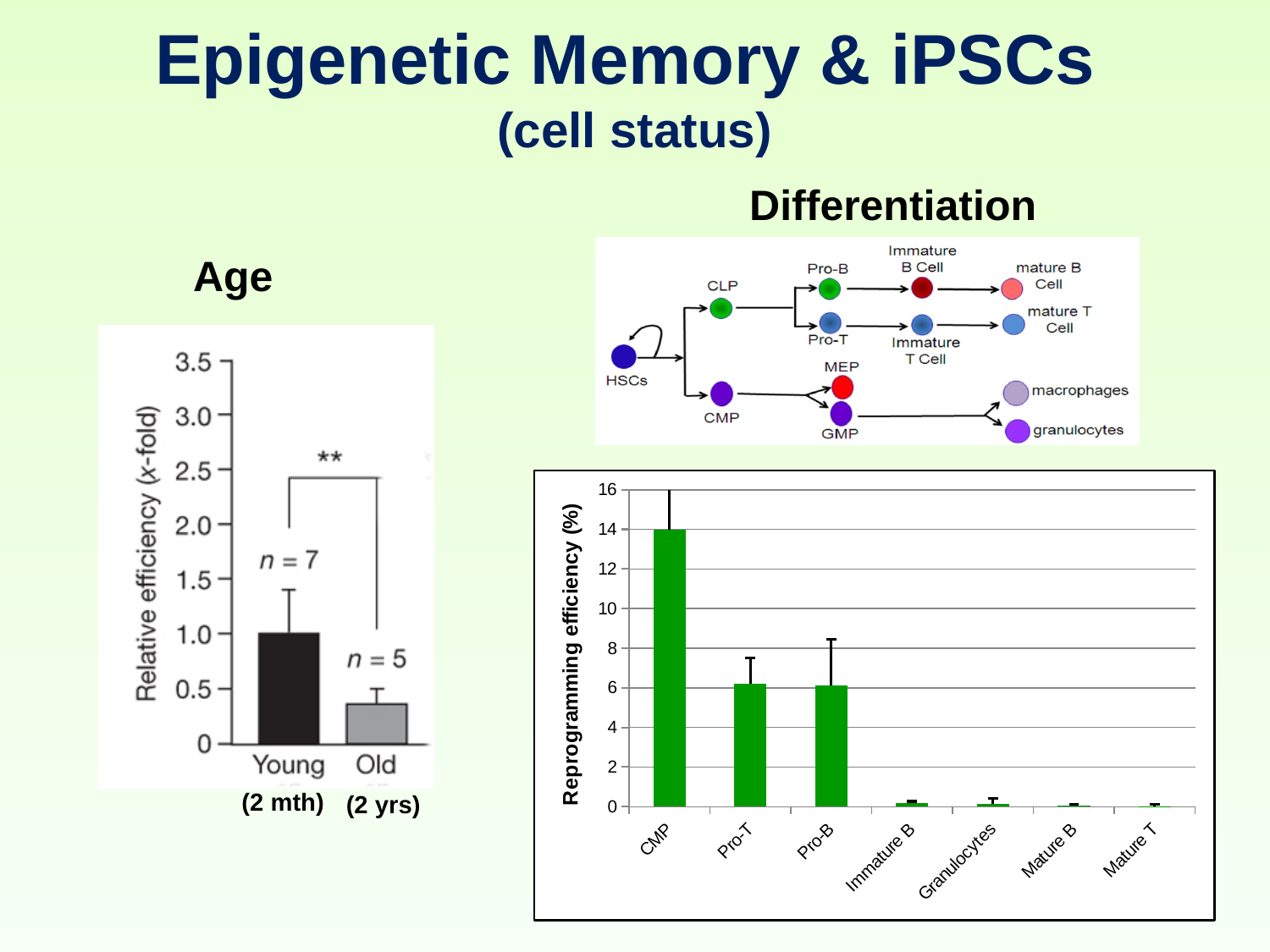
What kind of chart is the Age chart on the left of the slide? bar chart How many categories are shown on the x axis of the Reprogramming efficiency chart? 7 How many categories are shown on the x axis of the Age chart? 2 In the Reprogramming efficiency chart, is the value for CMP greater or less than 12? greater What is the y-axis label of the Reprogramming efficiency chart? Reprogramming efficiency (%) In the Reprogramming efficiency chart on the right, which category has the highest value? CMP In the Age chart, is the value for Old greater or less than 0.5? less In the Age chart, what is the sample size n shown above the Old bar? n = 5 In the Age chart, what is the relative efficiency value for Young? 1.0 In the Reprogramming efficiency chart, is the value for Pro-T greater or less than 8? less In the Age chart, what is the sample size n shown above the Young bar? n = 7 In the Age chart, which bar is higher, Young or Old? Young